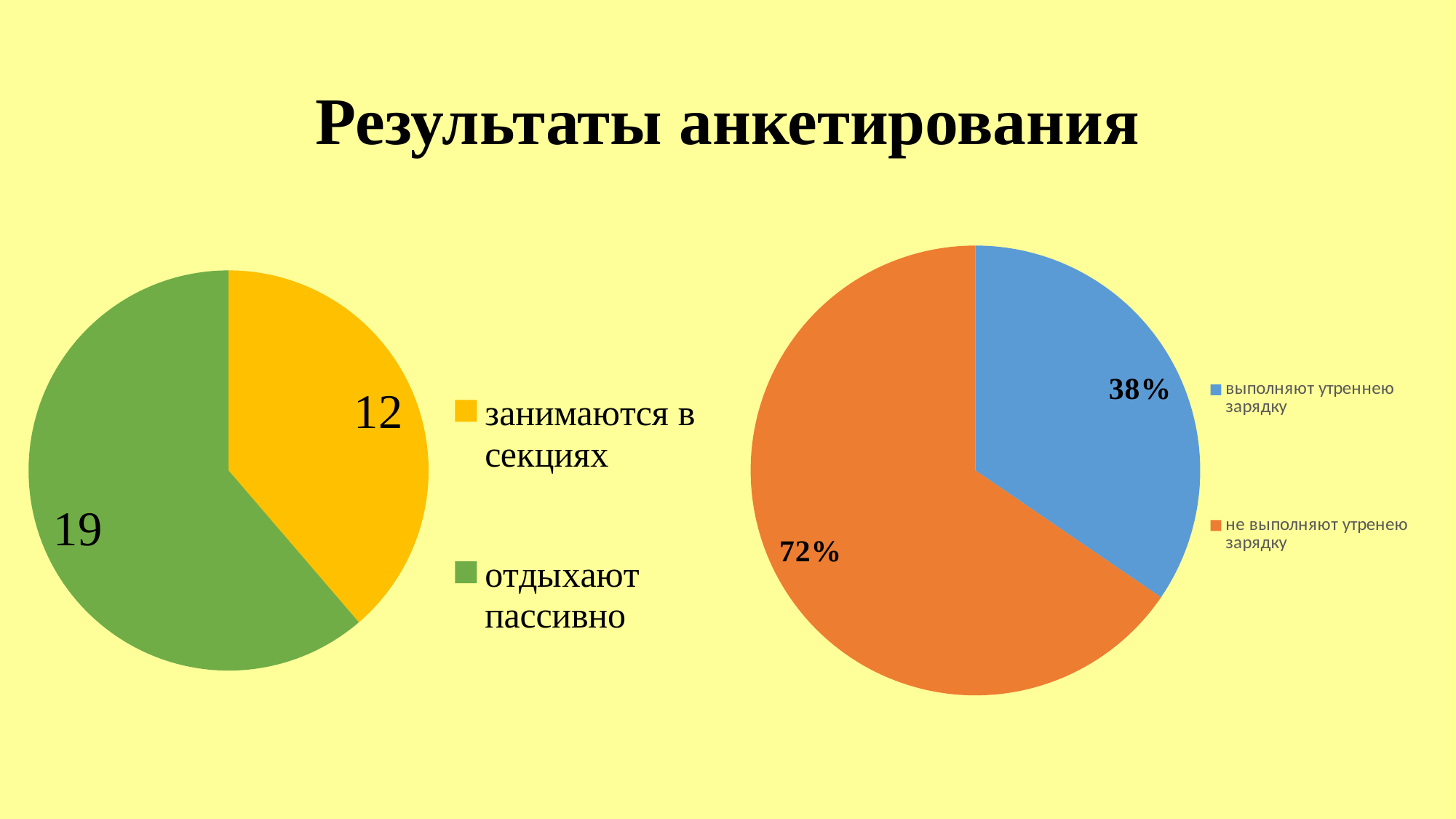
In the right pie chart, what percentage is shown for "выполняют утреннею зарядку"? 38% In the right pie chart, which category has the smaller share? выполняют утреннею зарядку How many slices does the left pie chart have? 2 What type of chart is the left chart on the slide? pie chart In the right pie chart, which is larger: "выполняют утреннею зарядку" or "не выполняют утренею зарядку"? не выполняют утренею зарядку What is the title of the slide containing the two pie charts? Результаты анкетирования In the left pie chart, which category has the largest value? отдыхают пассивно In the right pie chart, what percentage is shown for "не выполняют утренею зарядку"? 72% In the left pie chart, what is the value for "занимаются в секциях"? 12 In the left pie chart, what is the total of the two slices? 31 In the left pie chart, what is the value for "отдыхают пассивно"? 19 In the left pie chart, what is the difference between "отдыхают пассивно" and "занимаются в секциях"? 7